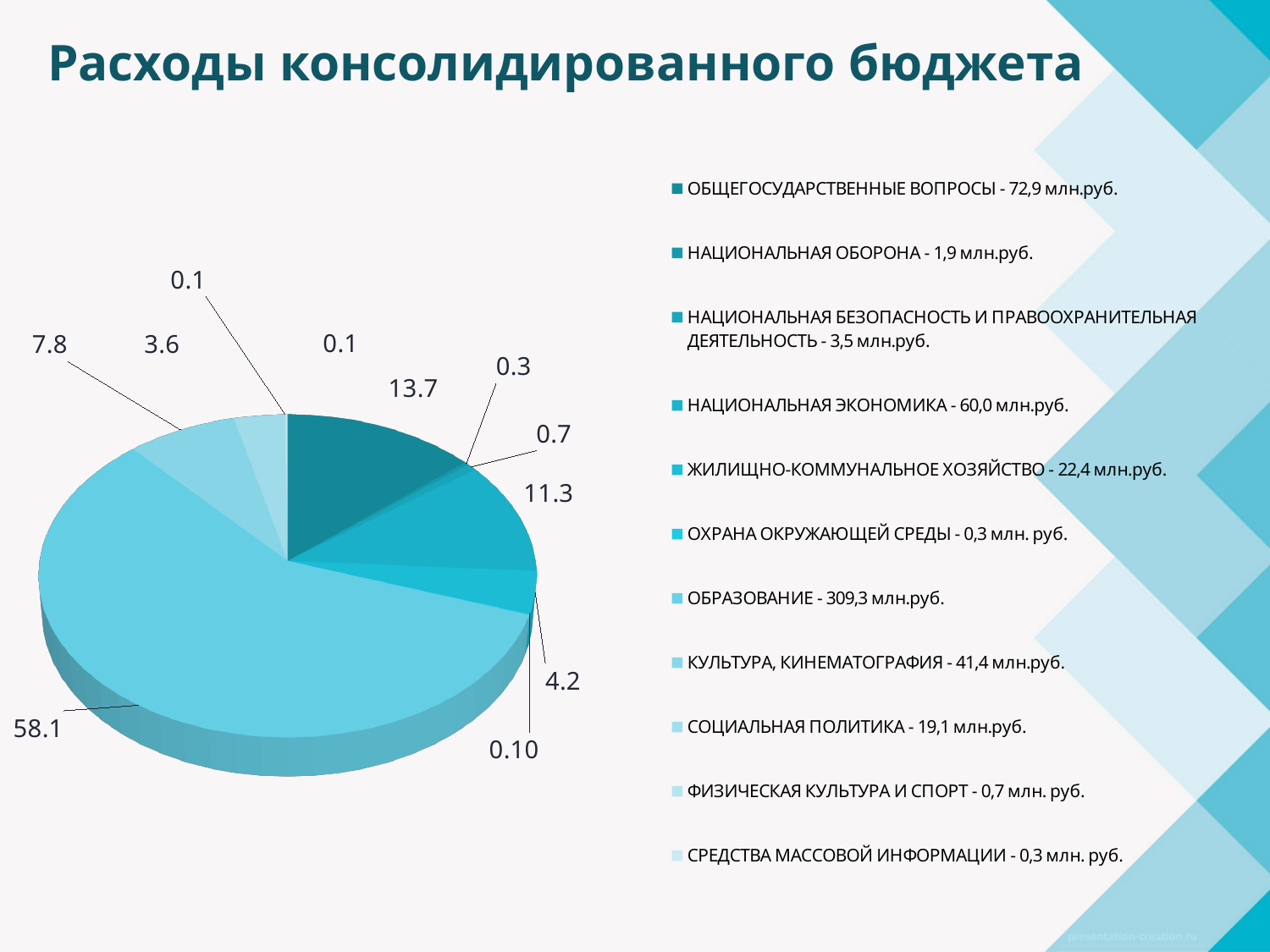
Which category has the largest slice of the pie chart? ОБРАЗОВАНИЕ What is the second-largest data label shown on the pie chart? 13.7 What value does the legend give for ОБРАЗОВАНИЕ? 309,3 млн.руб. What value does the legend give for ОБЩЕГОСУДАРСТВЕННЫЕ ВОПРОСЫ? 72,9 млн.руб. What value does the legend give for НАЦИОНАЛЬНАЯ ОБОРОНА? 1,9 млн.руб. What is the title of the chart on the slide? Расходы консолидированного бюджета What kind of chart is shown on the slide? Pie chart According to the legend, which is larger: НАЦИОНАЛЬНАЯ ЭКОНОМИКА or КУЛЬТУРА, КИНЕМАТОГРАФИЯ? НАЦИОНАЛЬНАЯ ЭКОНОМИКА How many categories does the legend of the pie chart list? 11 What data label is shown on the largest slice of the pie chart? 58.1 According to the legend, what is the difference between ОБЩЕГОСУДАРСТВЕННЫЕ ВОПРОСЫ and НАЦИОНАЛЬНАЯ ЭКОНОМИКА? 12,9 млн.руб. What value does the legend give for ЖИЛИЩНО-КОММУНАЛЬНОЕ ХОЗЯЙСТВО? 22,4 млн.руб.